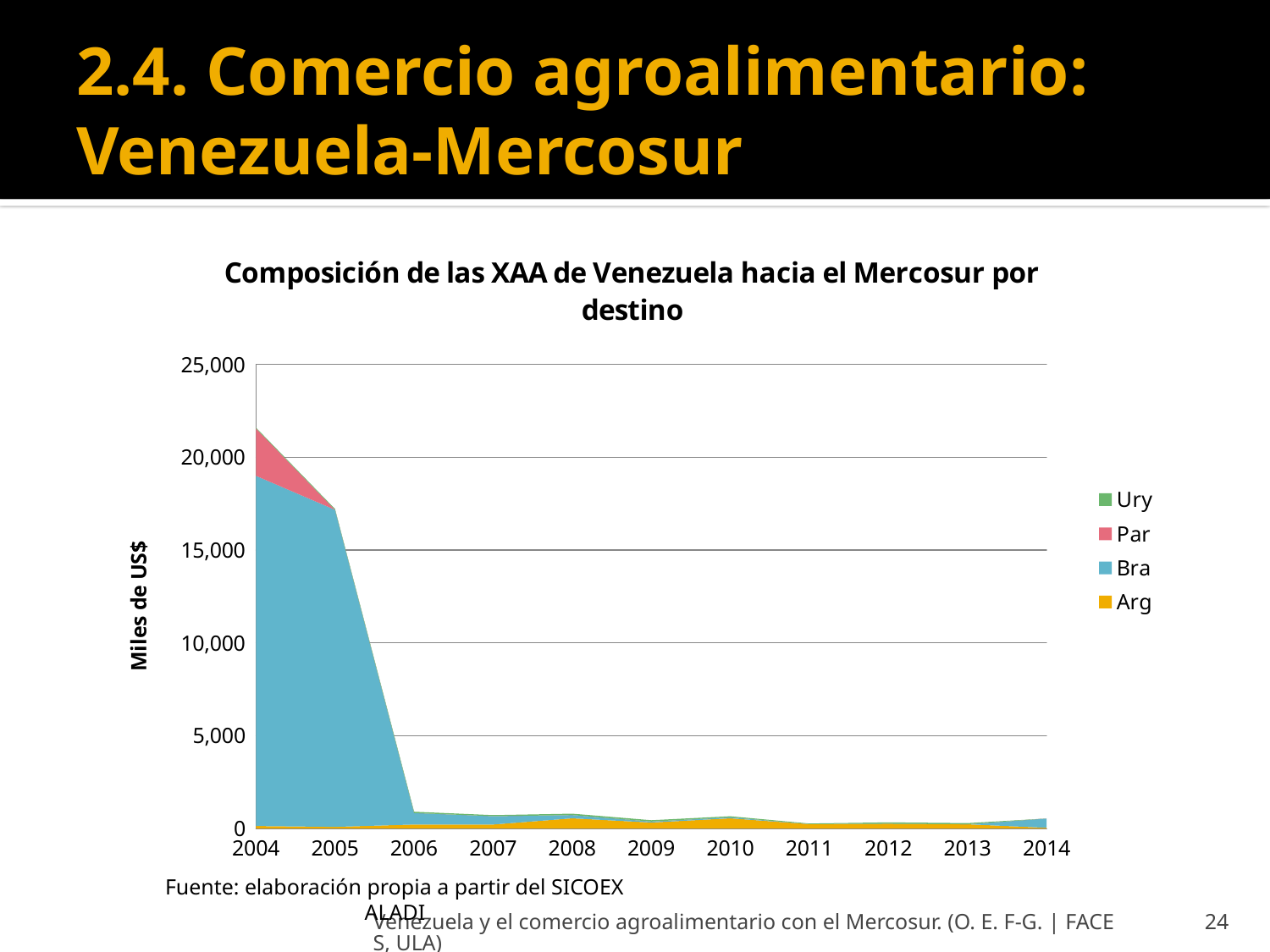
How many years are shown along the x axis? 11 What is the title of the chart? Composición de las XAA de Venezuela hacia el Mercosur por destino What kind of chart is shown on the slide? Stacked area chart Is the total value for 2005 greater or less than 15,000? greater Which year has the highest total value? 2004 Which is larger, the total value for 2004 or the total value for 2010? 2004 What is the label on the vertical axis? Miles de US$ Is the total value for 2004 greater or less than 20,000? greater Do the total values generally rise or fall from 2004 to 2014? Fall Is the total value for 2006 greater or less than 5,000? less How many series does the legend list? 4